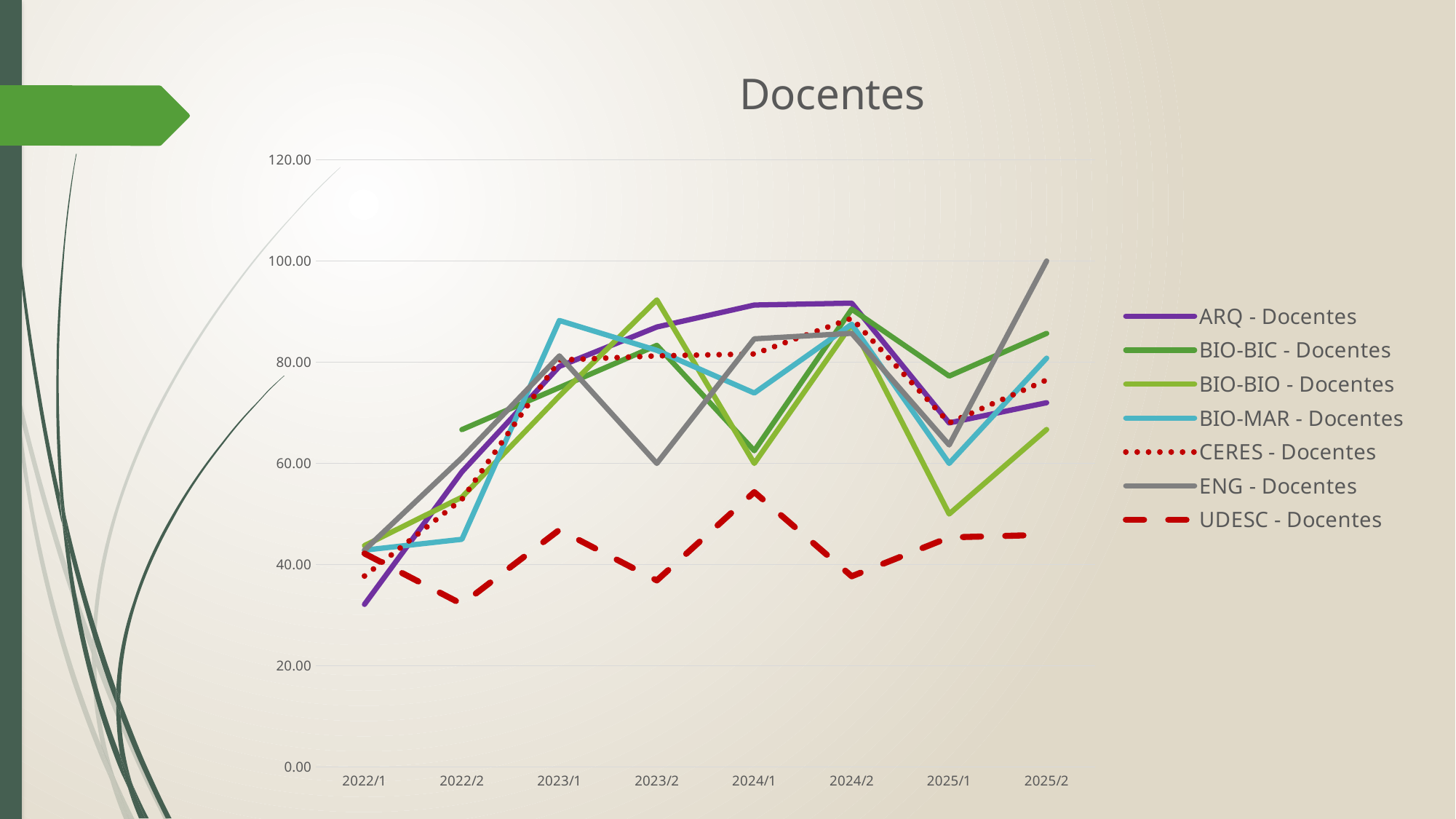
Which series has the lowest value at 2022/1? ARQ - Docentes Which series has the highest value at 2023/2? BIO-BIO - Docentes Which series has the highest value at 2025/2? ENG - Docentes What kind of chart is shown on the slide? line chart Is the value for BIO-BIO - Docentes at 2023/2 greater or less than 80? greater How many series does the legend list? 7 How many periods are shown along the x axis? 8 Does the value for ENG - Docentes rise or fall from 2025/1 to 2025/2? rise At 2025/1, which is larger: BIO-BIC - Docentes or BIO-BIO - Docentes? BIO-BIC - Docentes What is the title of the chart? Docentes Is the value for UDESC - Docentes at 2022/2 greater or less than 40? less Which series is drawn with a dotted line? CERES - Docentes